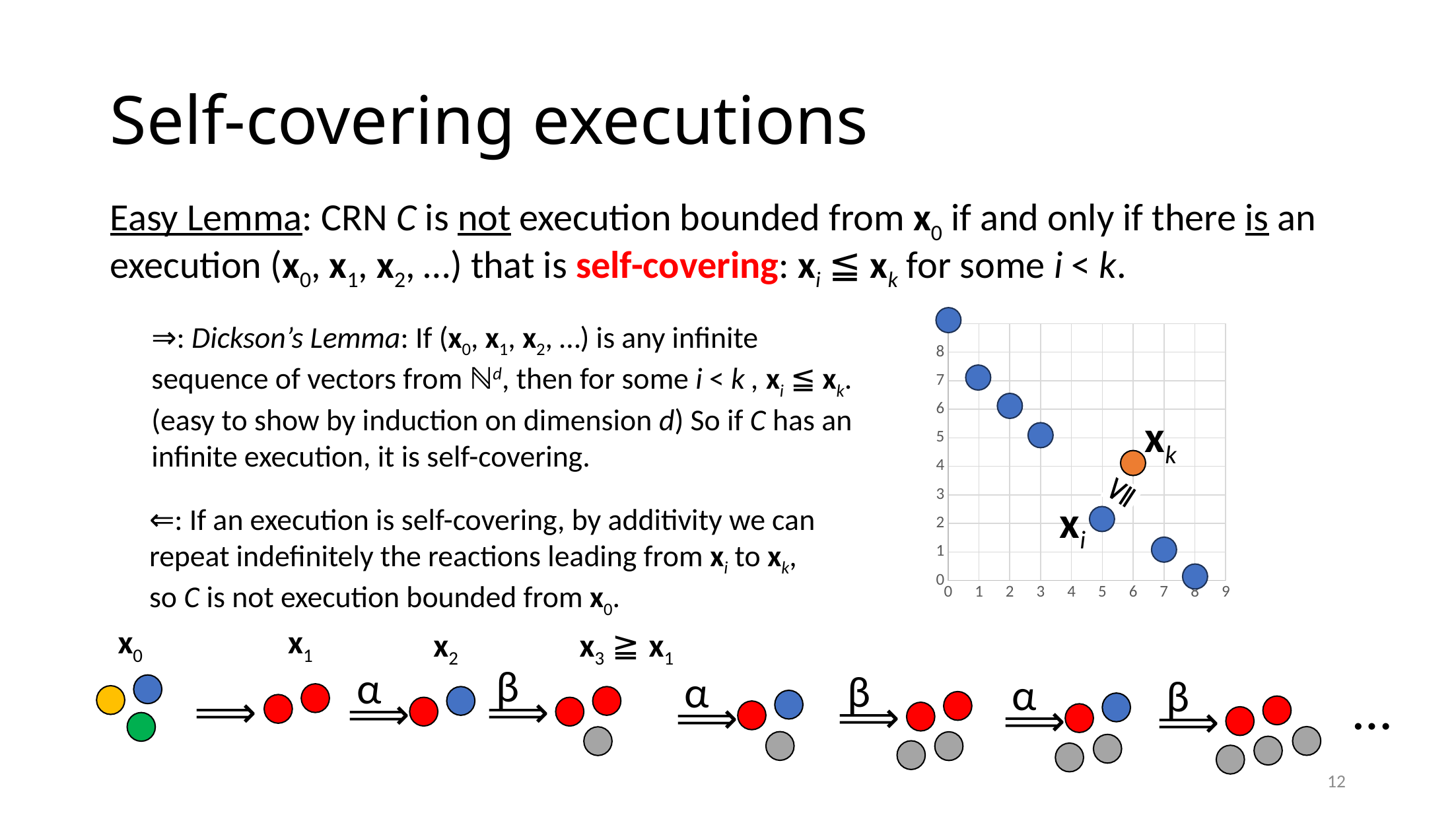
In the scatter chart, which point has the lowest y-value? the point at x = 8 How many points are plotted in the scatter chart? 8 What kind of chart is shown on the right of the slide? scatter chart In the scatter chart, what are the coordinates of the point labelled x_k? (6, 4) In the scatter chart, is the y-value of the point at x = 0 greater or less than 8? greater In the scatter chart, which point is coloured orange? x_k In the scatter chart, what is the y-value of the point at x = 1? 7 In the scatter chart, which point has the highest y-value? the point at x = 0 In the scatter chart, what are the coordinates of the point labelled x_i? (5, 2) In the scatter chart, what is the difference between the y-values of x_k and x_i? 2 In the scatter chart, what is the y-value of the point at x = 8? 0 In the scatter chart, which has the larger y-value, x_i or x_k? x_k